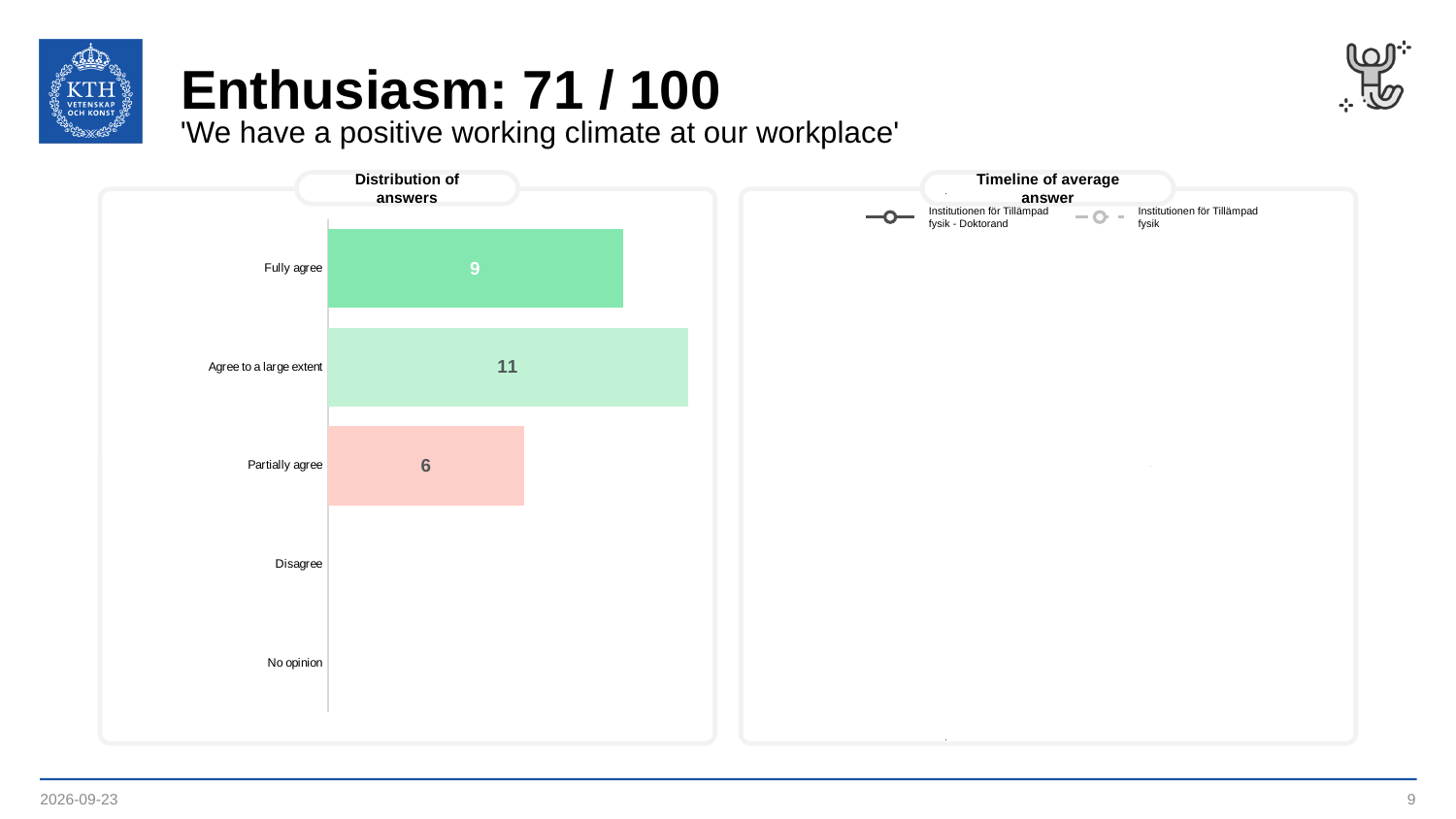
In the 'Distribution of answers' chart, what is the value for 'Agree to a large extent'? 11 What kind of chart is the 'Distribution of answers' chart? Bar chart How many series does the legend of the 'Timeline of average answer' chart list? 2 In the 'Distribution of answers' chart, what is the value for 'Fully agree'? 9 In the 'Distribution of answers' chart, what is the total of the three labelled bars? 26 In the 'Distribution of answers' chart, what is the difference between 'Agree to a large extent' and 'Partially agree'? 5 In the 'Distribution of answers' chart, which is larger: 'Fully agree' or 'Partially agree'? Fully agree In the 'Distribution of answers' chart, which category has the highest value? Agree to a large extent In the 'Distribution of answers' chart, what is the difference between 'Agree to a large extent' and 'Fully agree'? 2 How many categories are listed on the axis of the 'Distribution of answers' chart? 5 In the 'Distribution of answers' chart, what is the value for 'Partially agree'? 6 In the 'Distribution of answers' chart, which of the labelled bars has the lowest value? Partially agree